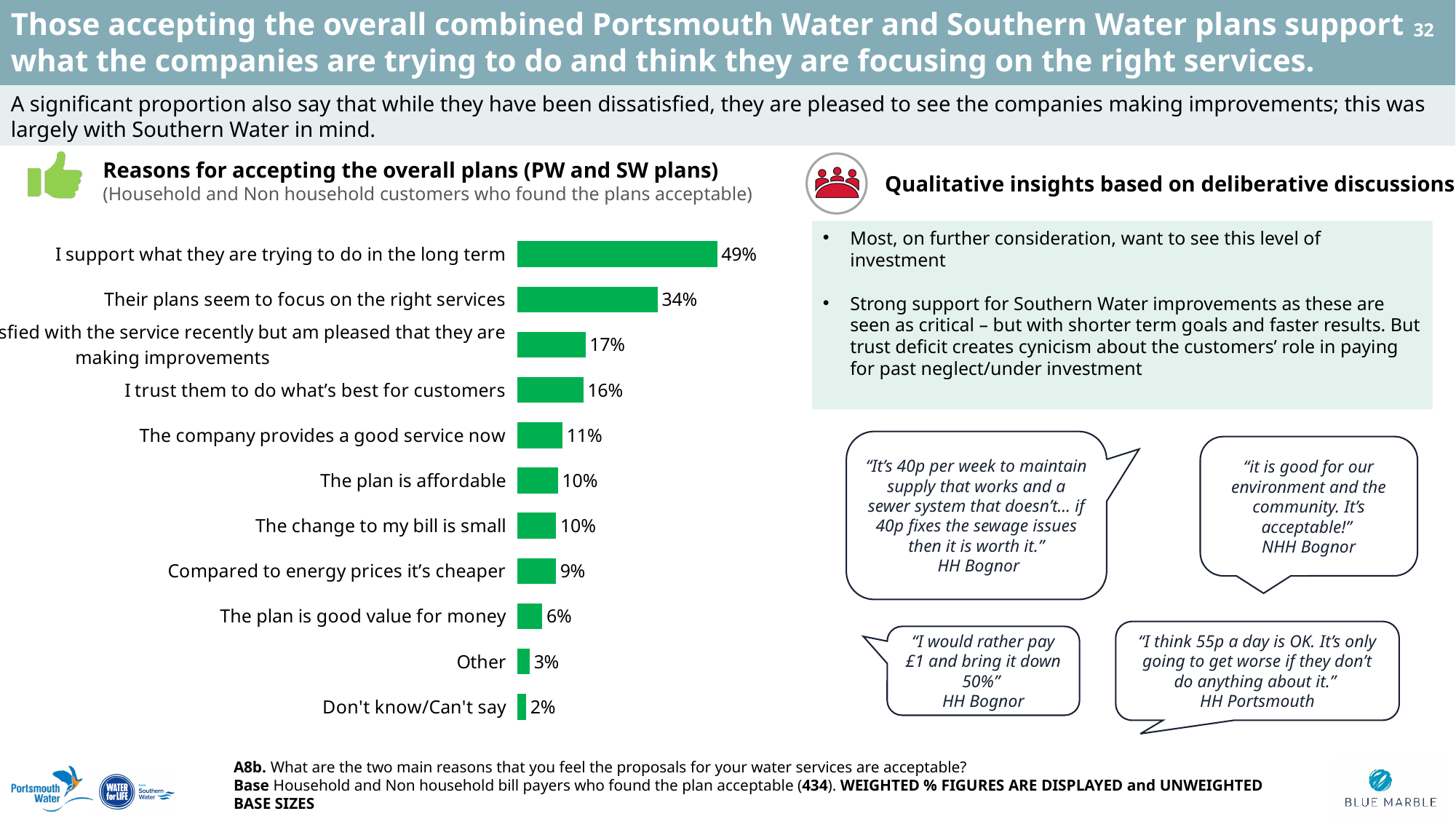
What percentage of respondents said "I support what they are trying to do in the long term" as a reason for accepting the overall plans? 49% What is the value for "I trust them to do what's best for customers"? 16% What percentage chose "Their plans seem to focus on the right services"? 34% What type of chart is used to show the reasons for accepting the overall plans? Bar chart What percentage said "The plan is good value for money"? 6% Which is larger: the value for "The company provides a good service now" or for "Compared to energy prices it's cheaper"? The company provides a good service now Which category in the chart has the lowest percentage? Don't know/Can't say How many categories (reasons) are shown in the bar chart? 11 What is the difference in percentage points between "I support what they are trying to do in the long term" and "Their plans seem to focus on the right services"? 15 Which reason for accepting the overall plans has the highest percentage? I support what they are trying to do in the long term What percentage of respondents answered "Other"? 3% What is the base size shown for the chart of reasons for accepting the overall plans? 434